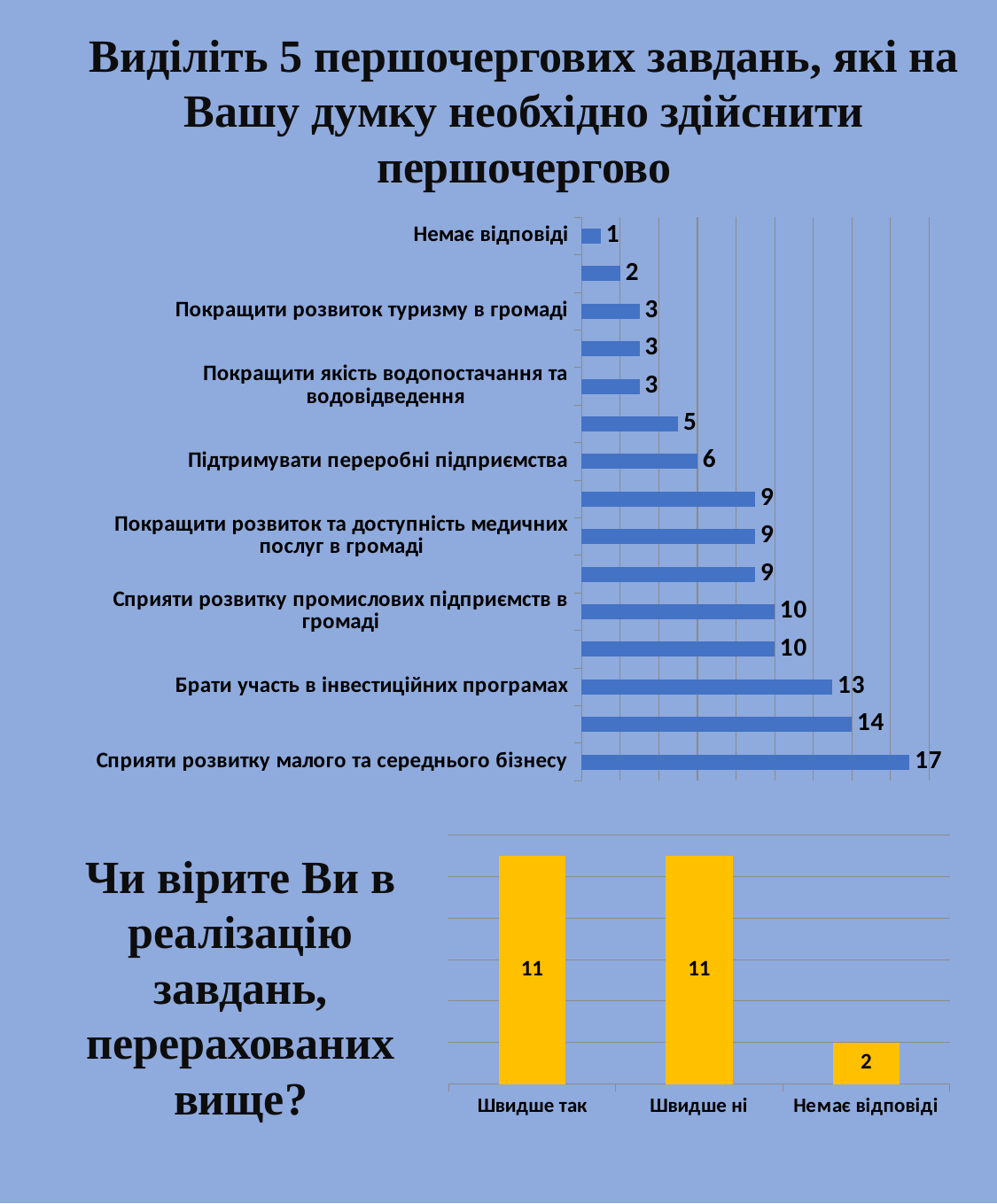
In the bottom chart, what is the value for 'Немає відповіді'? 2 In the top chart, what is the value for 'Сприяти розвитку малого та середнього бізнесу'? 17 In the bottom chart, what is the difference between the values for 'Швидше ні' and 'Немає відповіді'? 9 In the top chart, which has the larger value: 'Сприяти розвитку промислових підприємств в громаді' or 'Покращити розвиток та доступність медичних послуг в громаді'? Сприяти розвитку промислових підприємств в громаді In the top chart, what is the value for 'Підтримувати переробні підприємства'? 6 In the top chart, what is the value for 'Брати участь в інвестиційних програмах'? 13 In the top chart, which labelled category has the highest value? Сприяти розвитку малого та середнього бізнесу What kind of chart is the top chart on the slide? Bar chart In the top chart, which labelled category has the lowest value? Немає відповіді In the top chart, what is the difference between the values for 'Сприяти розвитку малого та середнього бізнесу' and 'Брати участь в інвестиційних програмах'? 4 How many categories are shown in the bottom chart? 3 In the bottom chart, what is the value for 'Швидше так'? 11